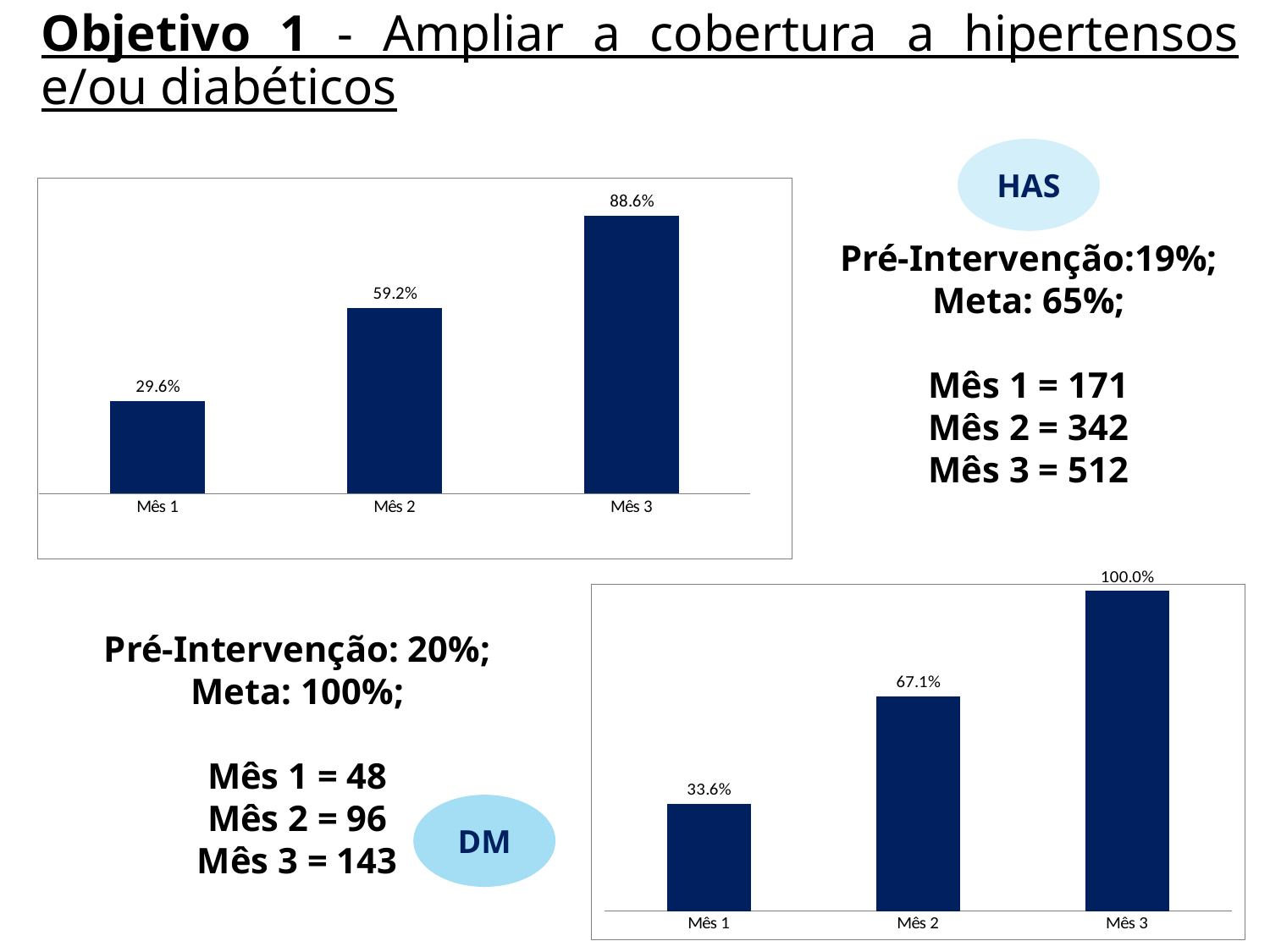
In the top-left chart, do the values rise or fall from Mês 1 to Mês 3? rise In the top-left chart, what is the value for Mês 3? 88.6% In the bottom-right chart, what is the value for Mês 1? 33.6% In the top-left chart, which month has the lowest value? Mês 1 What kind of chart is the bottom-right chart? bar chart In the top-left chart, how many bars are plotted? 3 In the top-left chart, what is the difference between the values for Mês 3 and Mês 1? 59.0 percentage points In the top-left chart, what is the value for Mês 2? 59.2% Which is larger: the value for Mês 2 in the top-left chart or the value for Mês 2 in the bottom-right chart? Mês 2 in the bottom-right chart In the bottom-right chart, which month has the highest value? Mês 3 In the bottom-right chart, what is the difference between the values for Mês 3 and Mês 1? 66.4 percentage points In the bottom-right chart, what is the value for Mês 2? 67.1%